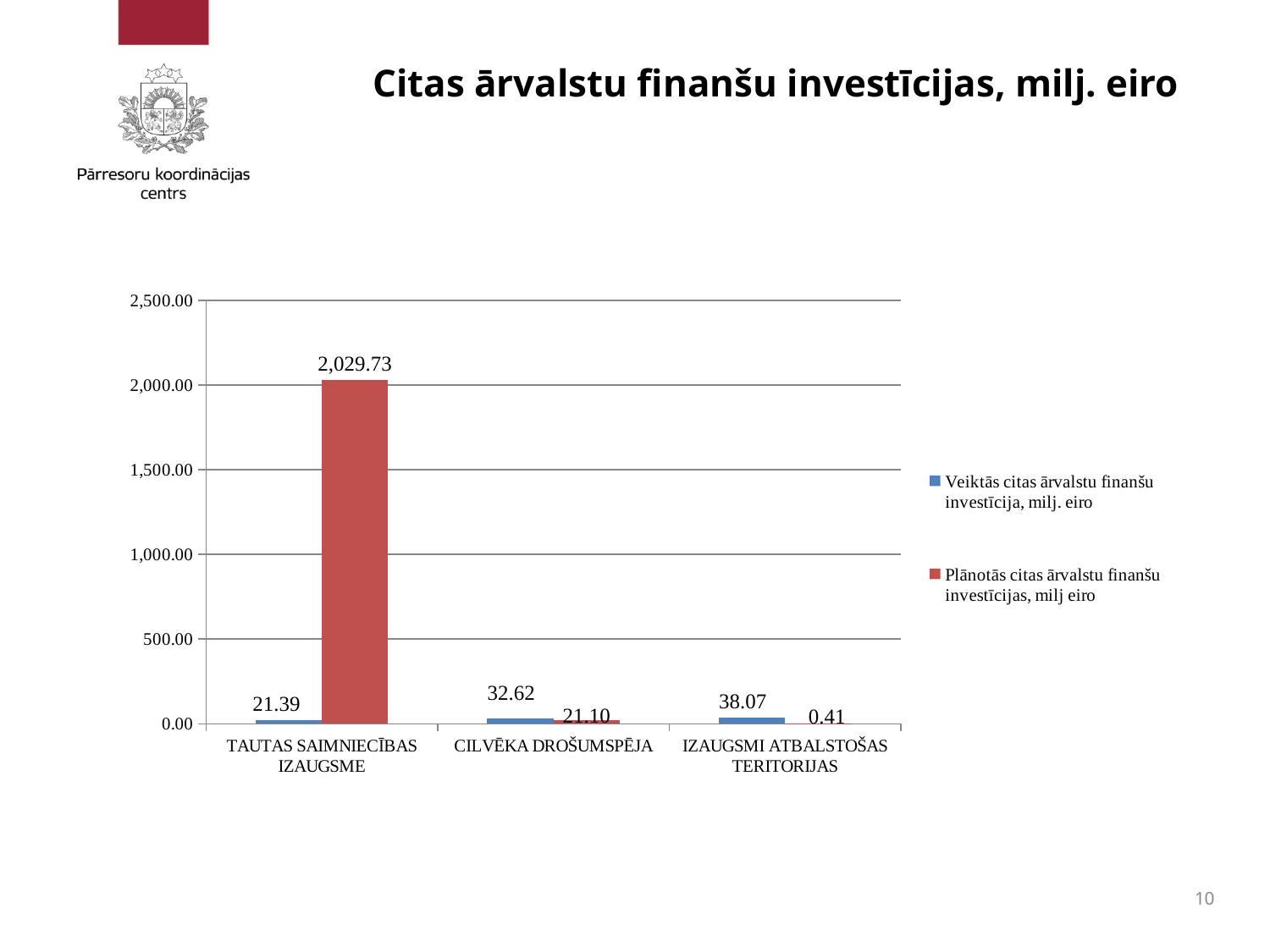
Which category has the lowest value for Plānotās citas ārvalstu finanšu investīcijas? IZAUGSMI ATBALSTOŠAS TERITORIJAS What is the value of Veiktās citas ārvalstu finanšu investīcija for CILVĒKA DROŠUMSPĒJA? 32.62 For CILVĒKA DROŠUMSPĒJA, which is larger: the Veiktās value or the Plānotās value? Veiktās What is the value of Plānotās citas ārvalstu finanšu investīcijas for TAUTAS SAIMNIECĪBAS IZAUGSME? 2,029.73 What kind of chart is shown on the slide? Bar chart What is the value of Plānotās citas ārvalstu finanšu investīcijas for IZAUGSMI ATBALSTOŠAS TERITORIJAS? 0.41 Which category has the highest value for Veiktās citas ārvalstu finanšu investīcija? IZAUGSMI ATBALSTOŠAS TERITORIJAS What is the value of Veiktās citas ārvalstu finanšu investīcija for TAUTAS SAIMNIECĪBAS IZAUGSME? 21.39 How many categories are shown on the x axis? 3 What is the difference between the Veiktās and Plānotās values for CILVĒKA DROŠUMSPĒJA? 11.52 How many series does the legend list? 2 What is the difference between the Plānotās and Veiktās values for TAUTAS SAIMNIECĪBAS IZAUGSME? 2,008.34